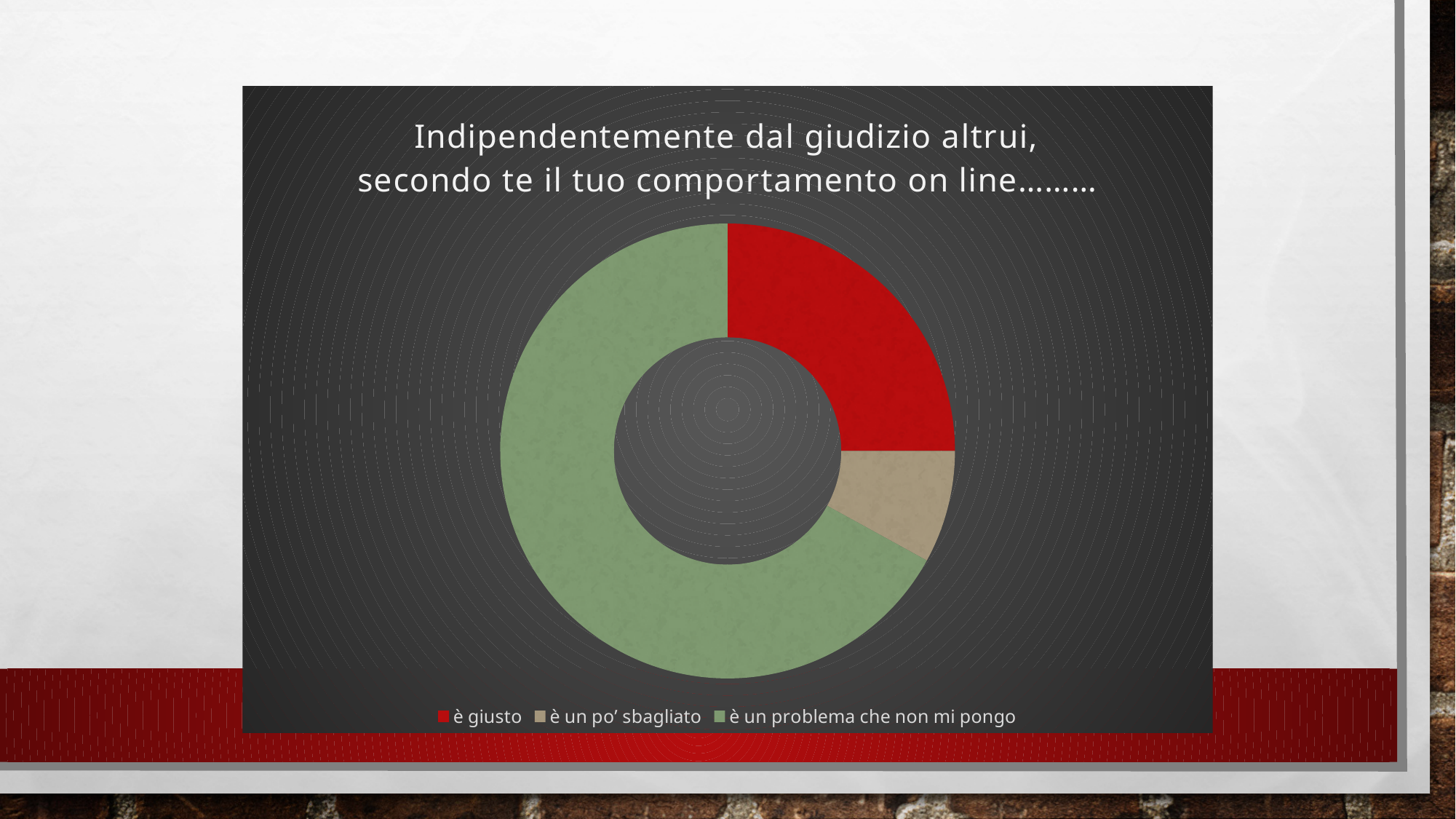
Which colour represents "è giusto" in the chart? red What is the title of the chart? Indipendentemente dal giudizio altrui, secondo te il tuo comportamento on line……… Which is larger, the share for "è giusto" or the share for "è un po' sbagliato"? è giusto Which category has the largest share of the chart? è un problema che non mi pongo How many entries does the legend list? 3 How many categories does the chart show? 3 Which is larger, the share for "è un problema che non mi pongo" or the share for "è giusto"? è un problema che non mi pongo What kind of chart is shown on the slide? doughnut chart Which category has the smallest share of the chart? è un po' sbagliato